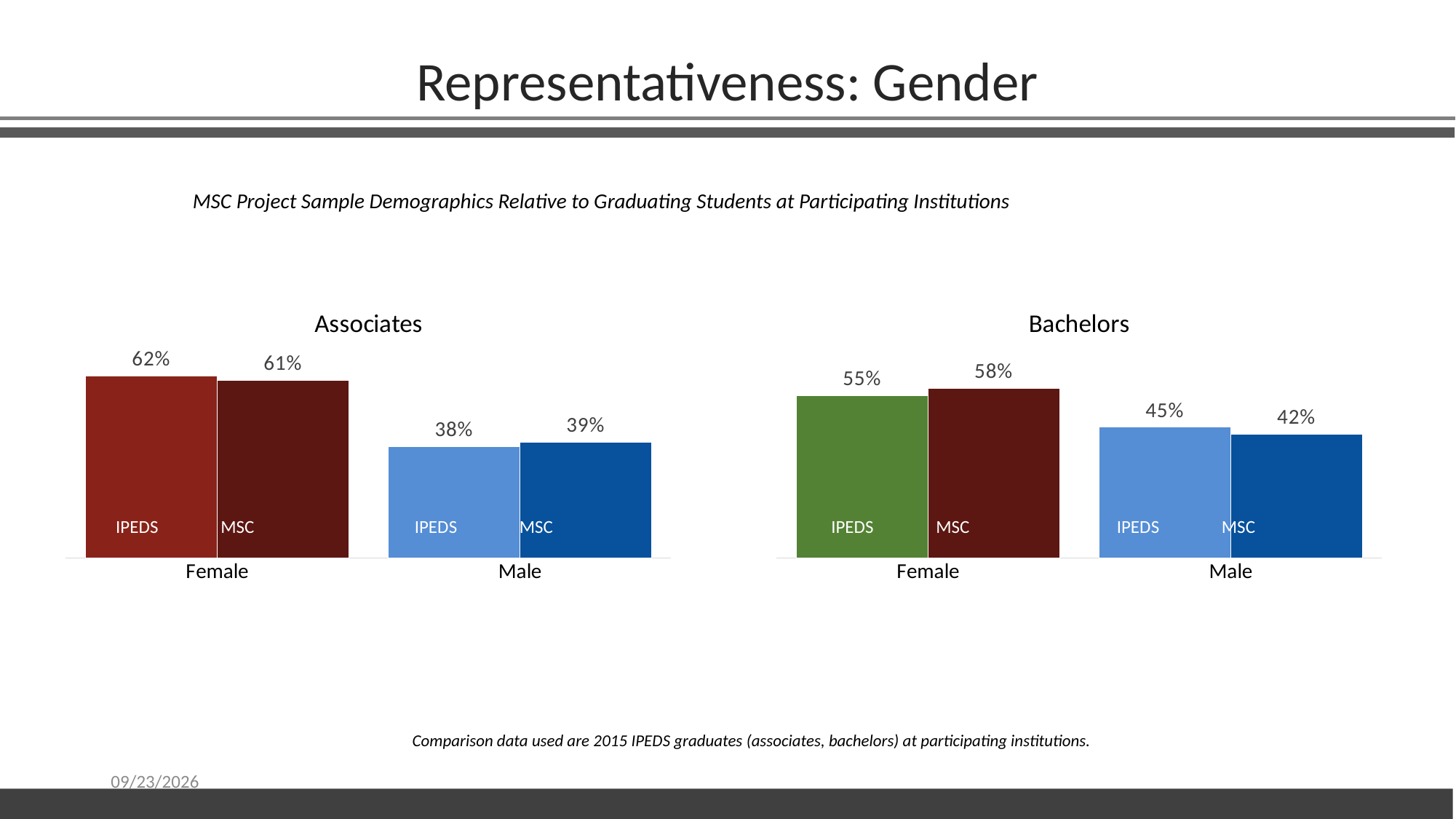
In the Bachelors chart, what is the IPEDS value for Male? 45% What is the title of the chart on the left side of the slide? Associates In the Bachelors chart, which is larger for Female: the IPEDS value or the MSC value? MSC What type of chart is the Bachelors chart? Bar chart In the Bachelors chart, what is the MSC value for Female? 58% In the Associates chart, what is the difference between the IPEDS value for Female and the IPEDS value for Male? 24% In the Associates chart, what is the IPEDS value for Female? 62% In the Bachelors chart, what is the difference between the IPEDS and MSC values for Male? 3% How many gender categories are shown on the x axis of the Associates chart? 2 In the Bachelors chart, which bar has the lowest value? MSC Male In the Associates chart, which bar has the highest value? IPEDS Female In the Associates chart, what is the MSC value for Male? 39%